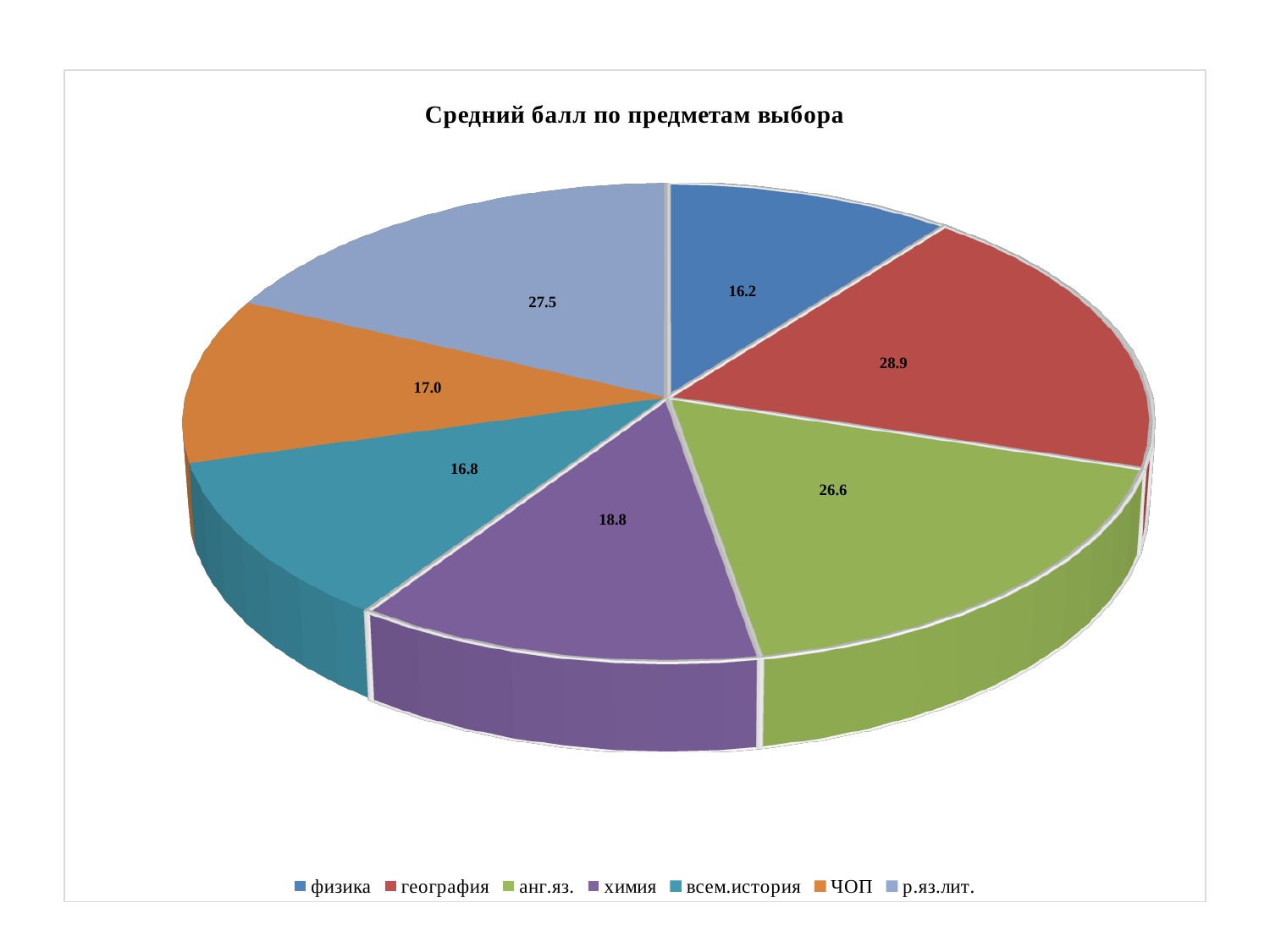
How many subjects (slices) are shown in the pie chart? 7 Which has the larger value, химия or ЧОП? химия Which subject has the highest value? география What kind of chart is shown on the slide? pie chart Which subject has the lowest value? физика What is the value shown for р.яз.лит.? 27.5 What is the value shown for химия? 18.8 What is the difference between the values for география and анг.яз.? 2.3 What is the title of the chart? Средний балл по предметам выбора What is the value shown for всем.история? 16.8 What colour is the slice for ЧОП? orange What is the value shown for география? 28.9